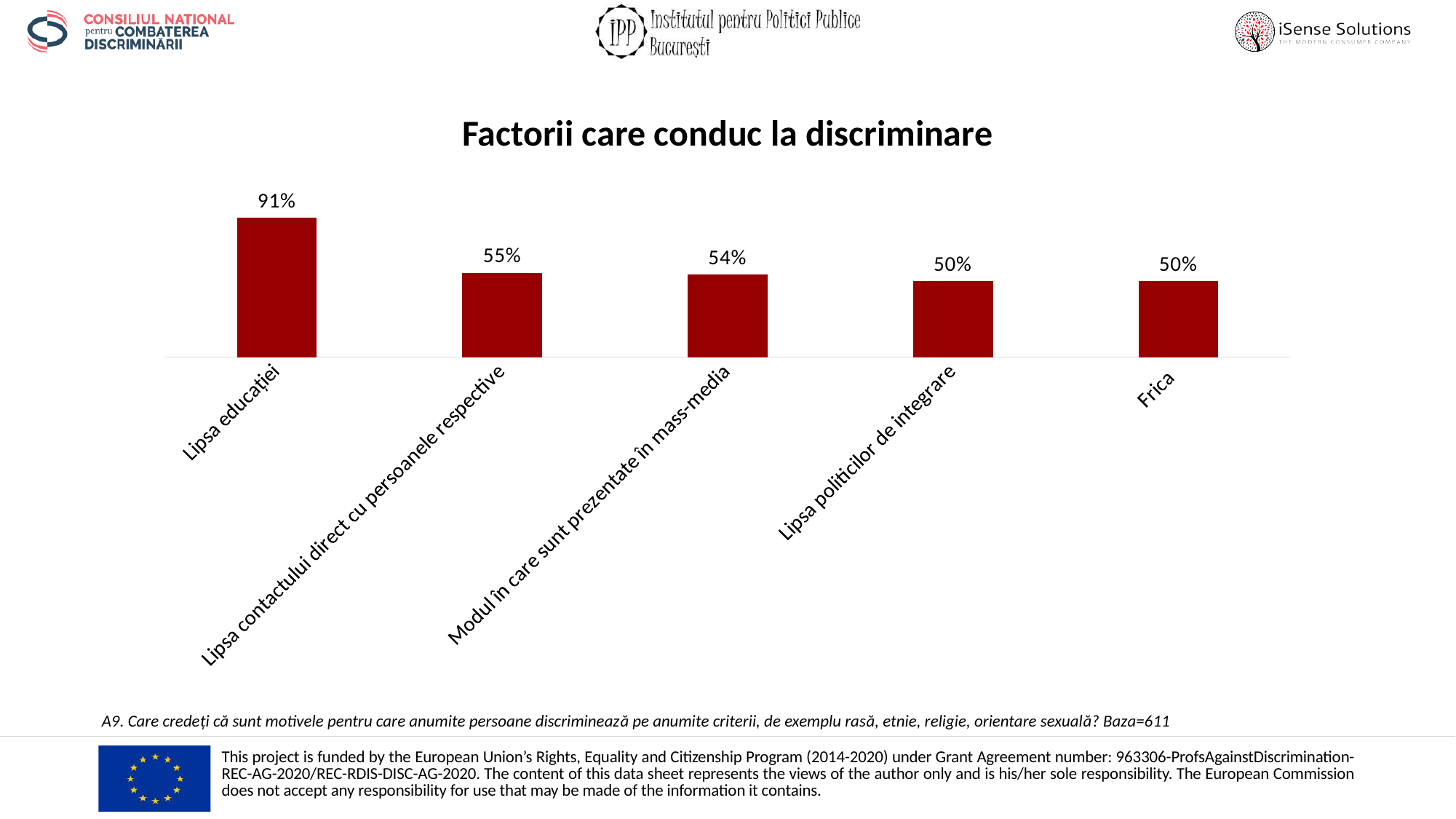
What is the value for Lipsa contactului direct cu persoanele respective? 55% Which category has the highest value? Lipsa educației What is the value for Modul în care sunt prezentate în mass-media? 54% What is the difference between the values for Modul în care sunt prezentate în mass-media and Frica? 4% What is the value for Lipsa educației? 91% Which is larger, the value for Lipsa educației or the value for Frica? Lipsa educației What is the value for Lipsa politicilor de integrare? 50% How many categories are shown in the chart? 5 What is the value for Frica? 50% What is the title of the chart? Factorii care conduc la discriminare What kind of chart is shown on the slide? Bar chart What is the difference between the values for Lipsa educației and Lipsa contactului direct cu persoanele respective? 36%